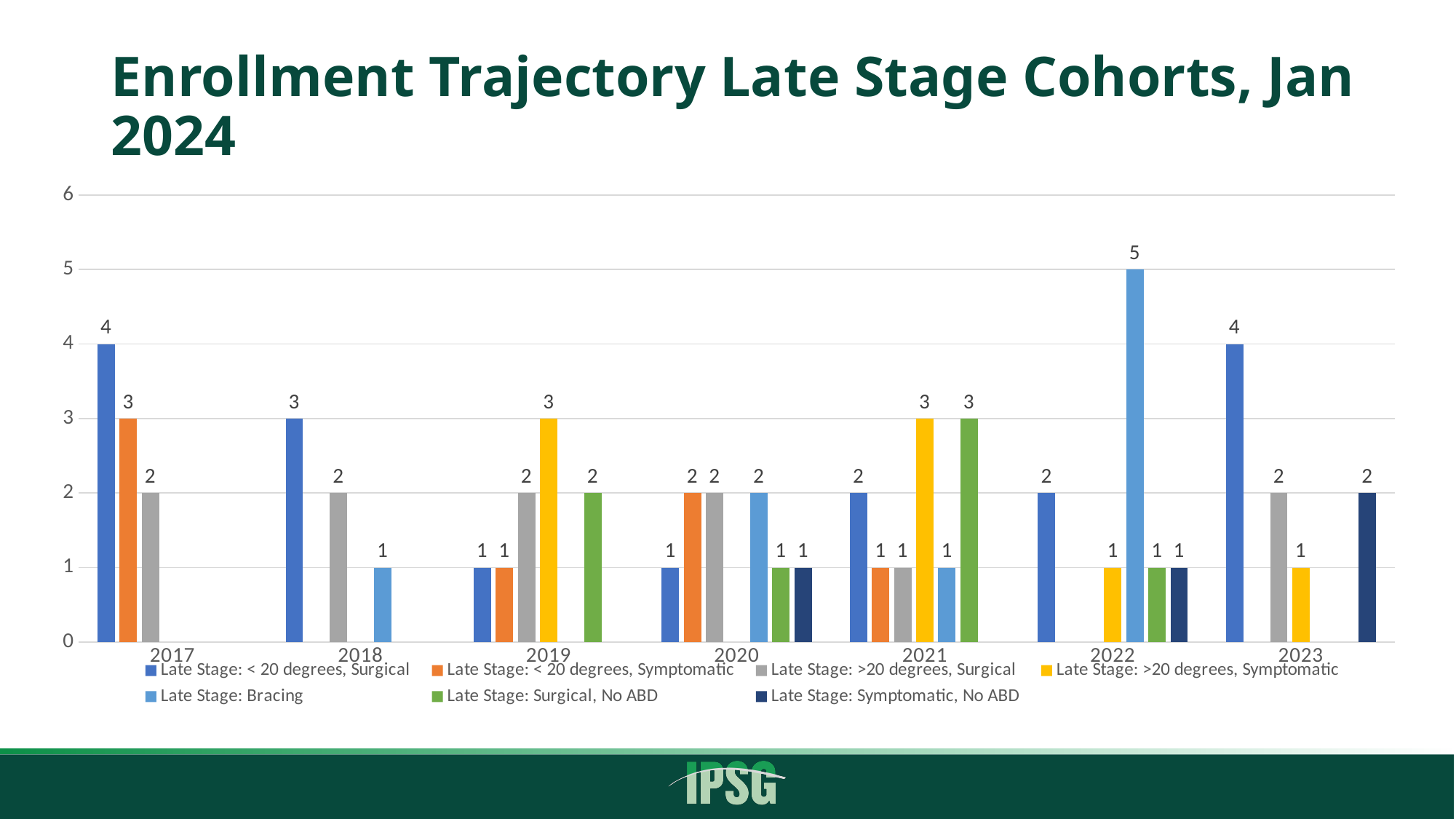
What kind of chart is shown on the slide? bar chart What is the value for Late Stage: < 20 degrees, Surgical in 2017? 4 What is the title of the chart? Enrollment Trajectory Late Stage Cohorts, Jan 2024 Which year has the tallest single bar in the chart? 2022 What is the value for Late Stage: >20 degrees, Symptomatic in 2019? 3 How many years are shown on the x axis? 7 What is the value for Late Stage: Symptomatic, No ABD in 2023? 2 Which is larger: Late Stage: < 20 degrees, Surgical in 2017 or Late Stage: < 20 degrees, Surgical in 2018? 2017 What is the difference between Late Stage: Bracing in 2022 and Late Stage: Bracing in 2018? 4 How many series does the legend list? 7 What is the value for Late Stage: Bracing in 2022? 5 Is the value for Late Stage: Bracing in 2022 greater or less than 4? greater